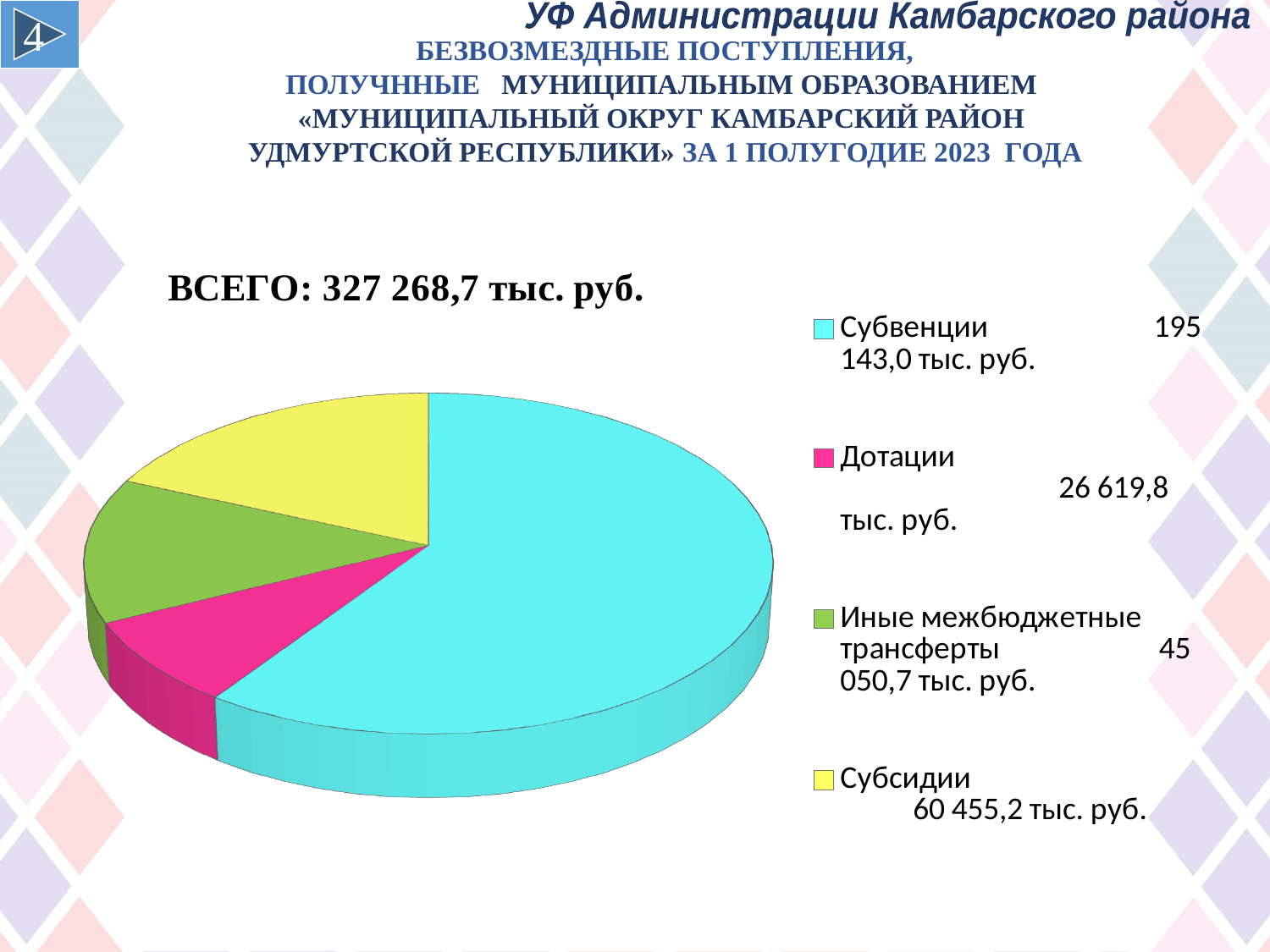
What is the value for Субвенции? 195 143,0 тыс. руб. What is the difference between Субвенции and Дотации? 168 523,2 тыс. руб. Which category has the smallest value? Дотации What type of chart is shown on the slide? pie chart Which is larger, Субсидии or Иные межбюджетные трансферты? Субсидии What is the total (ВСЕГО) shown on the slide? 327 268,7 тыс. руб. What is the value for Субсидии? 60 455,2 тыс. руб. What is the value for Дотации? 26 619,8 тыс. руб. What is the value for Иные межбюджетные трансферты? 45 050,7 тыс. руб. What colour is the slice for Субсидии? yellow How many categories does the pie chart show? 4 Which category has the largest value? Субвенции